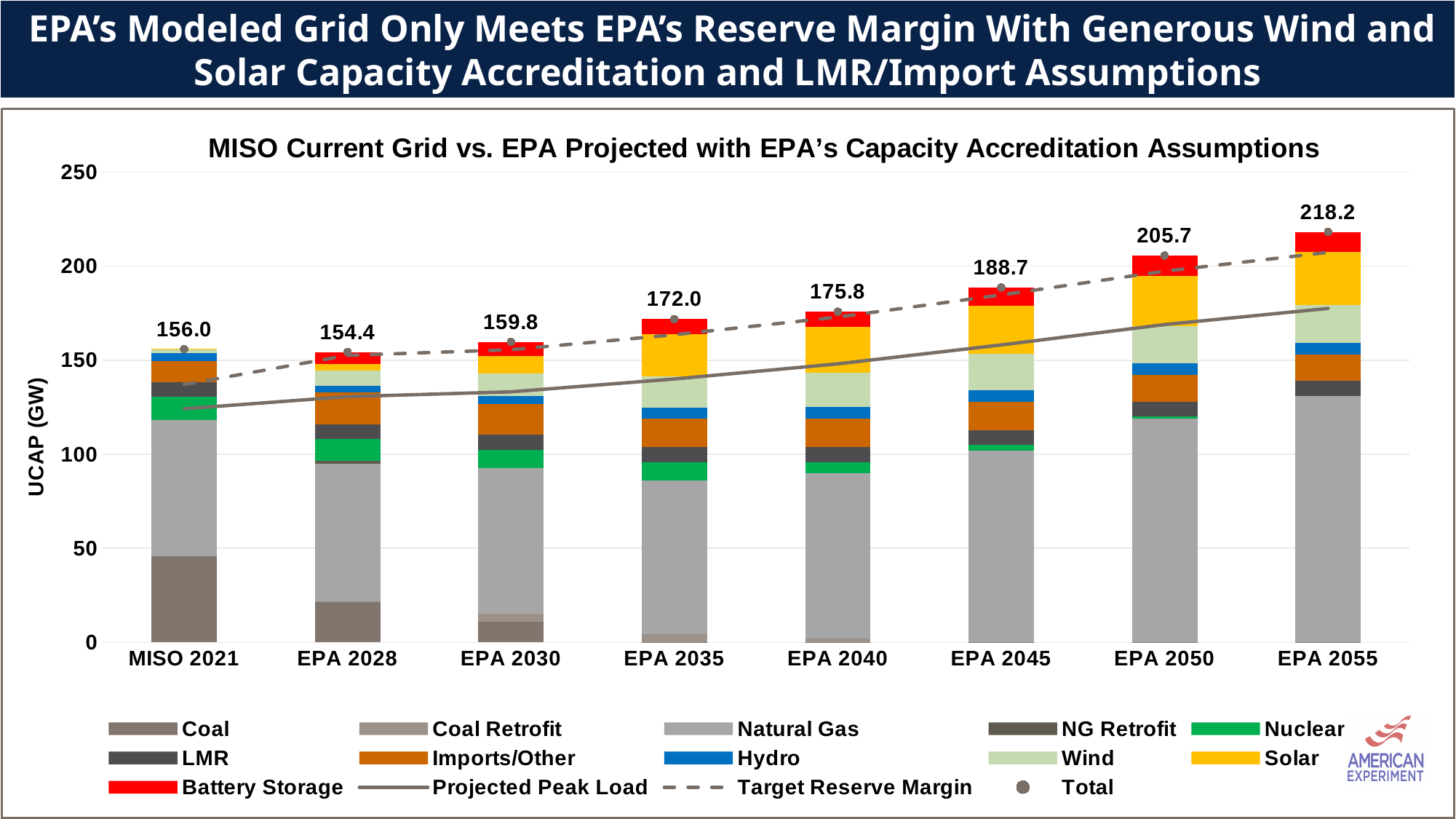
How many entries does the legend list? 14 Which category has the highest total UCAP? EPA 2055 Which has a larger total UCAP, EPA 2030 or EPA 2035? EPA 2035 What is the difference between the total for EPA 2050 and the total for EPA 2045? 17.0 Which category has the lowest total UCAP? EPA 2028 Is the Coal value for MISO 2021 greater or less than 50? less What is the total UCAP shown for EPA 2055? 218.2 What is the total UCAP shown for EPA 2040? 175.8 What kind of chart is this? Stacked bar chart with line overlays How many categories are shown on the x axis? 8 What is the total UCAP shown for MISO 2021? 156.0 Do the total UCAP values generally rise or fall from EPA 2028 to EPA 2055? rise